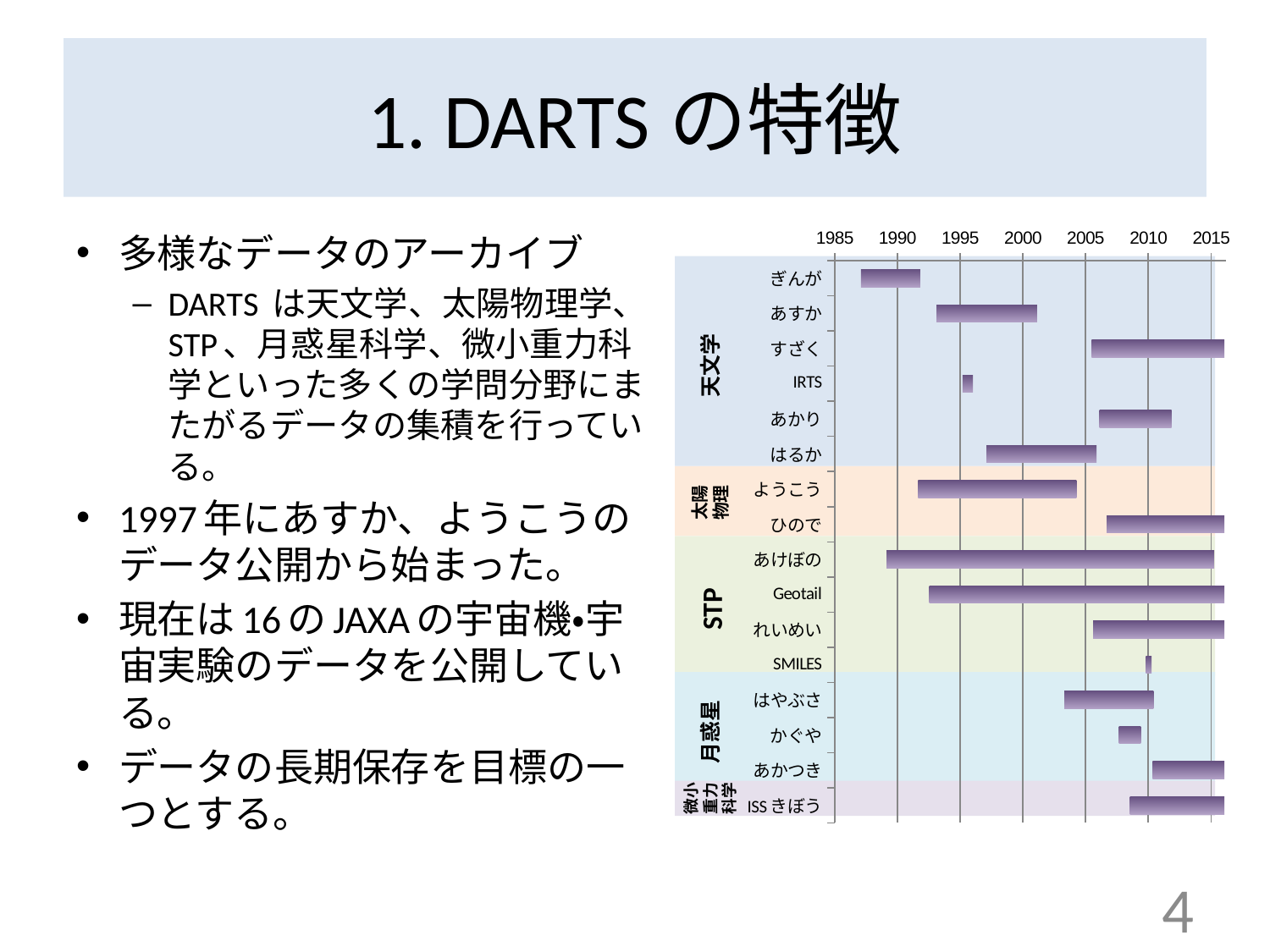
Is the start year of the Geotail bar greater or less than 1995? less Which bar is longer, あけぼの or かぐや? あけぼの Which mission's bar starts earliest on the time axis? ぎんが Is the start year of the ぎんが bar greater or less than 1990? less What kind of chart is shown on the slide? bar chart (horizontal timeline) How many missions (rows) are listed in the chart? 16 What is the last year label shown on the time axis? 2015 Is the end year of the あすか bar greater or less than 2000? greater Which mission started earlier, ようこう or ひので? ようこう Which mission has the longest bar in the chart? あけぼの How many missions are listed under the 天文学 group? 6